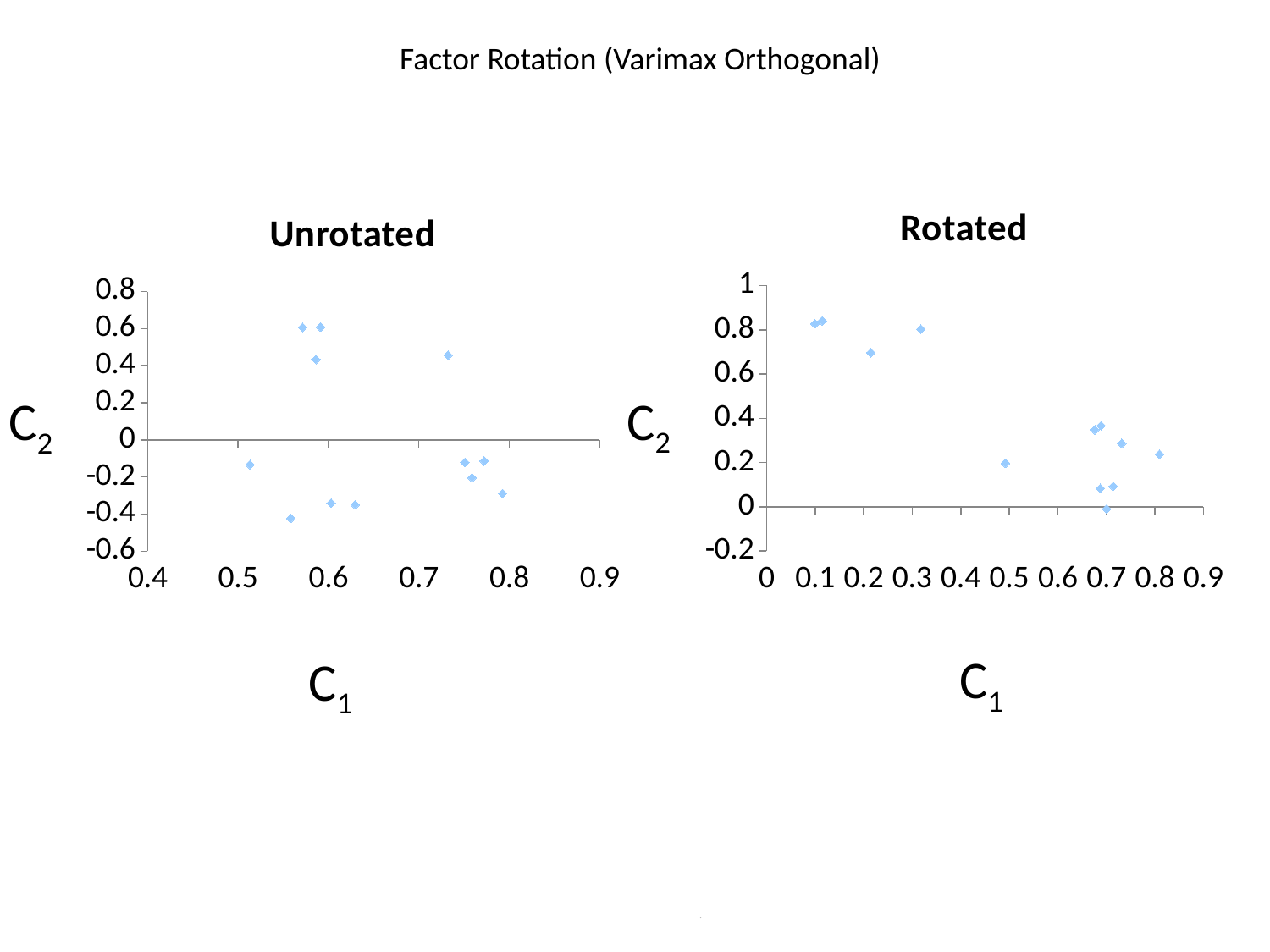
What kind of chart is the "Unrotated" chart? scatter chart In the "Unrotated" chart, is the C1 value of the leftmost point greater or less than 0.6? less In the "Rotated" chart, what is the highest value shown on the vertical axis? 1 What is the title of the chart on the right of the slide? Rotated What is the title of the chart on the left of the slide? Unrotated In the "Rotated" chart, are the points with C1 below 0.4 higher or lower in C2 than the points with C1 above 0.6? higher In the "Rotated" chart, is the highest point's C2 value greater or less than 0.6? greater In the "Unrotated" chart, is the highest point's C2 value greater or less than 0.4? greater What kind of chart is the "Rotated" chart? scatter chart